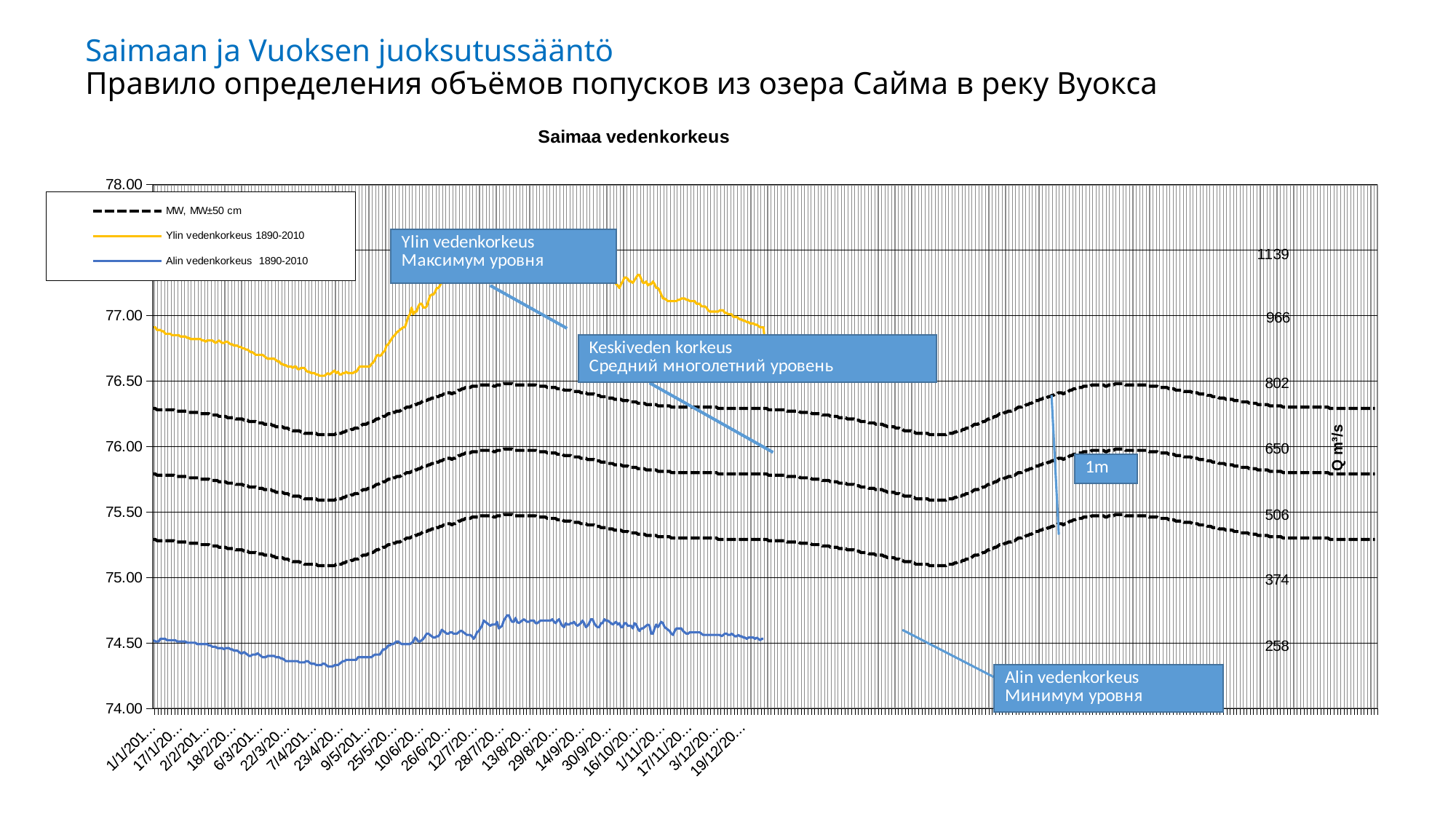
How many series does the chart legend list? 3 Is the peak of the Ylin vedenkorkeus 1890-2010 line greater or less than 77.00? greater Which legend entry is drawn as a black dashed line? MW, MW±50 cm Which series has higher values throughout the year, Ylin vedenkorkeus 1890-2010 or Alin vedenkorkeus 1890-2010? Ylin vedenkorkeus 1890-2010 What is the title of the chart? Saimaa vedenkorkeus Does the Ylin vedenkorkeus 1890-2010 line rise or fall between late April and mid-July? Rise What kind of chart is shown on the slide? Line chart Is the lowest point of the Alin vedenkorkeus 1890-2010 line greater or less than 74.00? greater Is the value of the Ylin vedenkorkeus 1890-2010 line at the start of the year (1/1) greater or less than 76.50? greater What is the highest value shown on the left vertical axis? 78.00